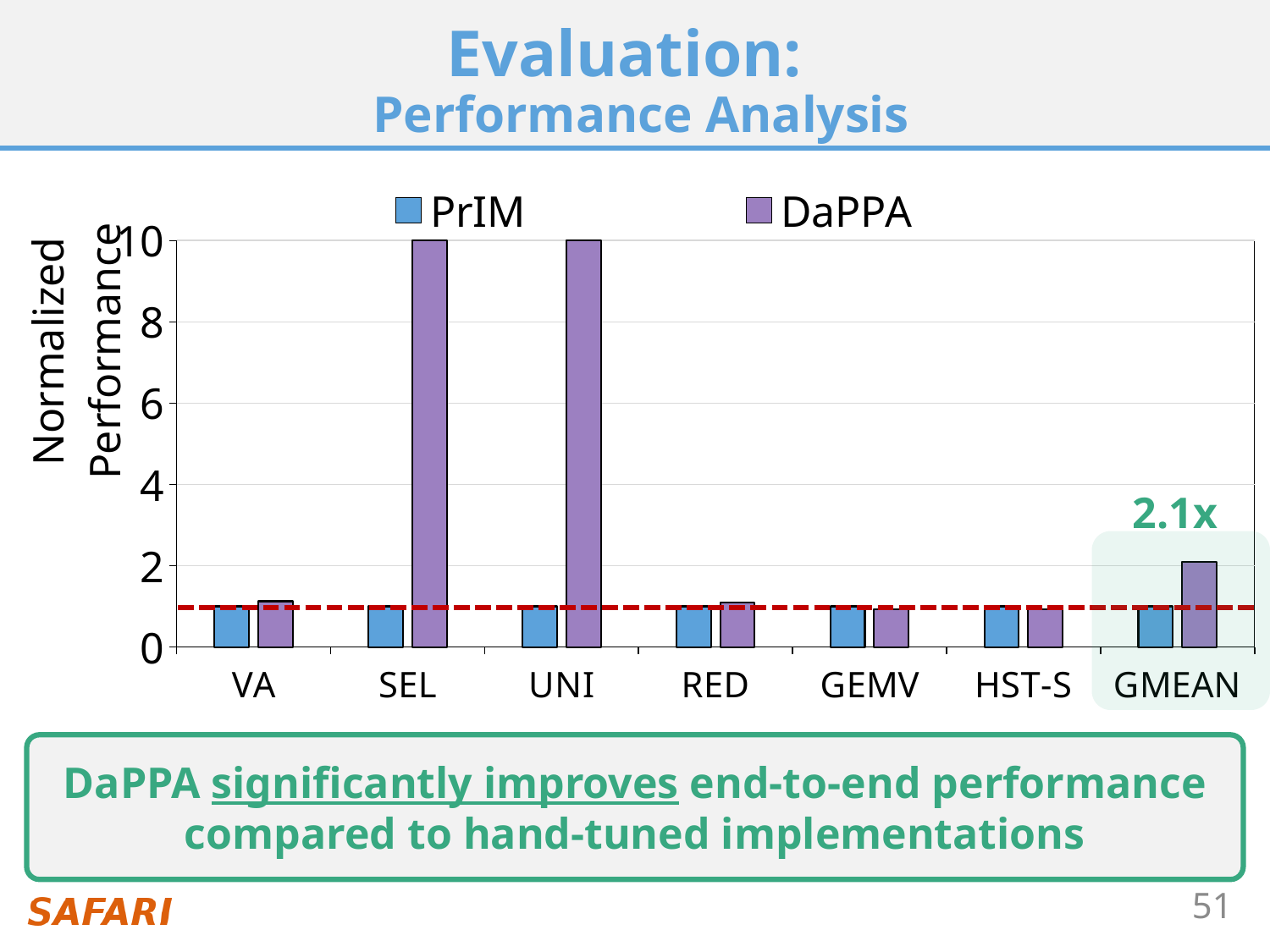
Is the DaPPA value for SEL greater or less than 8? greater Is the DaPPA value for VA greater or less than 2? less How many categories are shown on the x axis? 7 Which is larger, the DaPPA value for SEL or the DaPPA value for RED? SEL Is the PrIM value for RED greater or less than 2? less How many series does the legend list? 2 What kind of chart is shown on the slide? bar chart What is the label on the y axis? Normalized Performance Which is larger, the DaPPA value for UNI or the DaPPA value for GMEAN? UNI What are the two series named in the legend? PrIM and DaPPA What value is labelled above the GMEAN bars for DaPPA? 2.1x